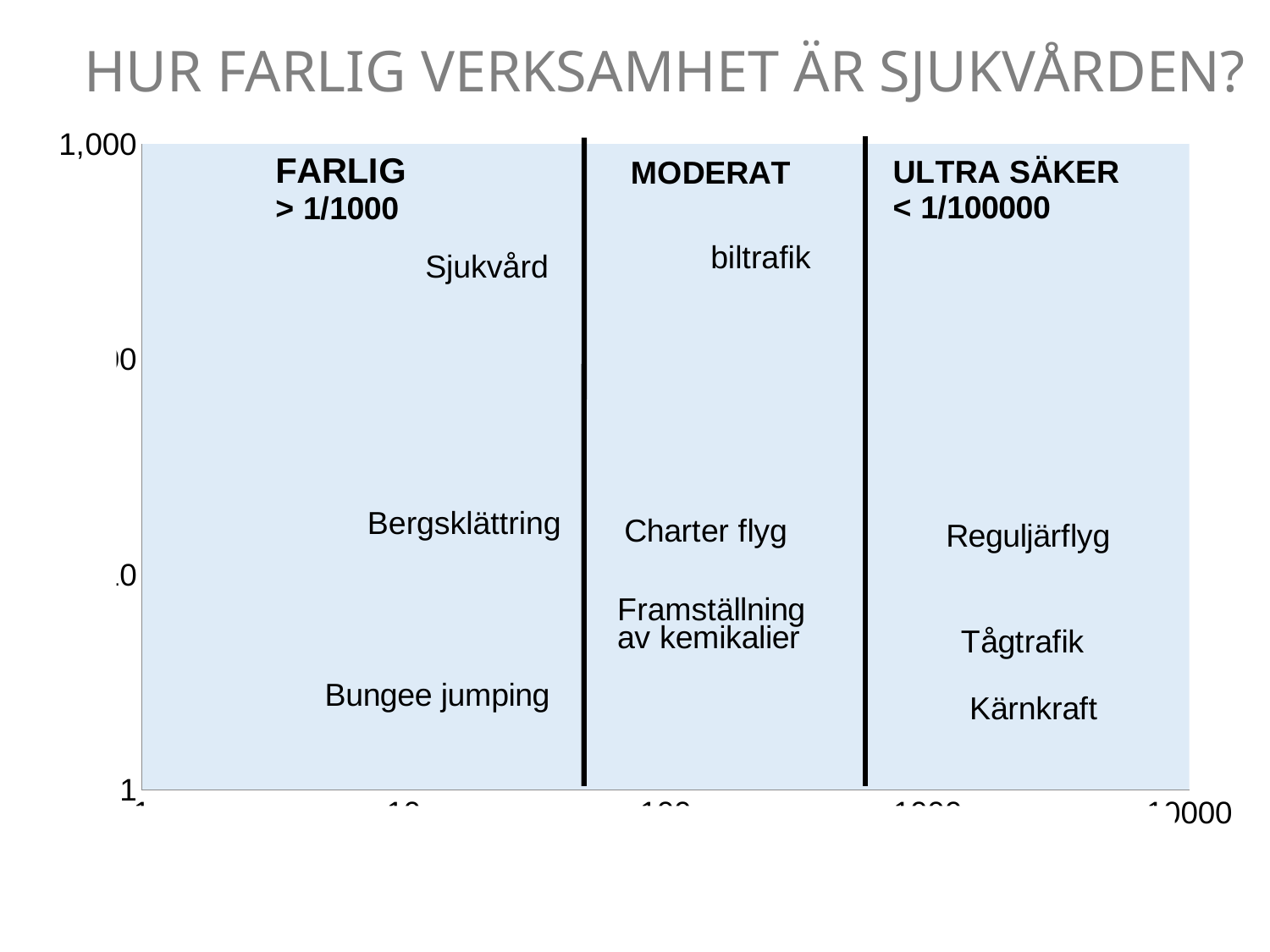
How many risk zones is the chart divided into? 3 Which is placed higher on the chart, Sjukvård or Bungee jumping? Sjukvård Which activity is placed highest in the FARLIG zone? Sjukvård What risk threshold is printed under the ULTRA SÄKER zone label? < 1/100000 In which zone of the chart is Sjukvård placed? FARLIG What is the title of the chart on the slide? HUR FARLIG VERKSAMHET ÄR SJUKVÅRDEN? Which activity is placed lowest in the ULTRA SÄKER zone? Kärnkraft In which zone of the chart is Kärnkraft placed? ULTRA SÄKER What risk threshold is printed under the FARLIG zone label? > 1/1000 In which zone of the chart is Charter flyg placed? MODERAT Is the horizontal position of Kärnkraft greater or less than 1000 on the x axis? greater How many activities are labelled inside the chart area? 9